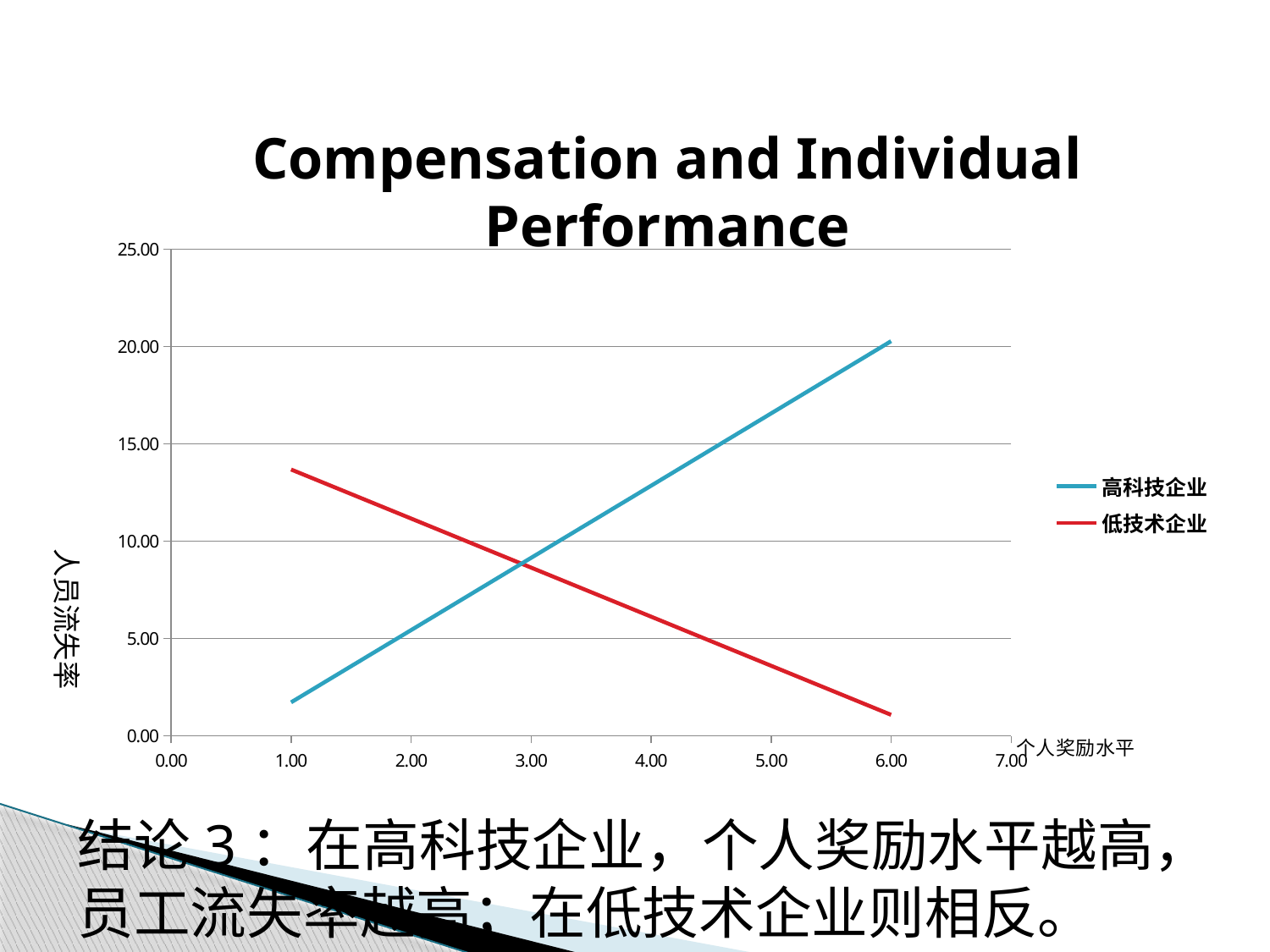
What kind of chart is shown on the slide? line chart Does the 高科技企业 line rise or fall as 个人奖励水平 increases along the x axis? rise What is the title of the chart? Compensation and Individual Performance Is the value for 低技术企业 at 1.00 on the x axis greater or less than 10.00? greater At 6.00 on the x axis, which series has the higher value, 高科技企业 or 低技术企业? 高科技企业 Is the value for 高科技企业 at 1.00 on the x axis greater or less than 5.00? less Is the value for 低技术企业 at 6.00 on the x axis greater or less than 5.00? less What is the label on the y axis of the chart? 人员流失率 How many series does the legend list? 2 At 1.00 on the x axis, which series has the higher value, 高科技企业 or 低技术企业? 低技术企业 Does the 低技术企业 line rise or fall as 个人奖励水平 increases along the x axis? fall